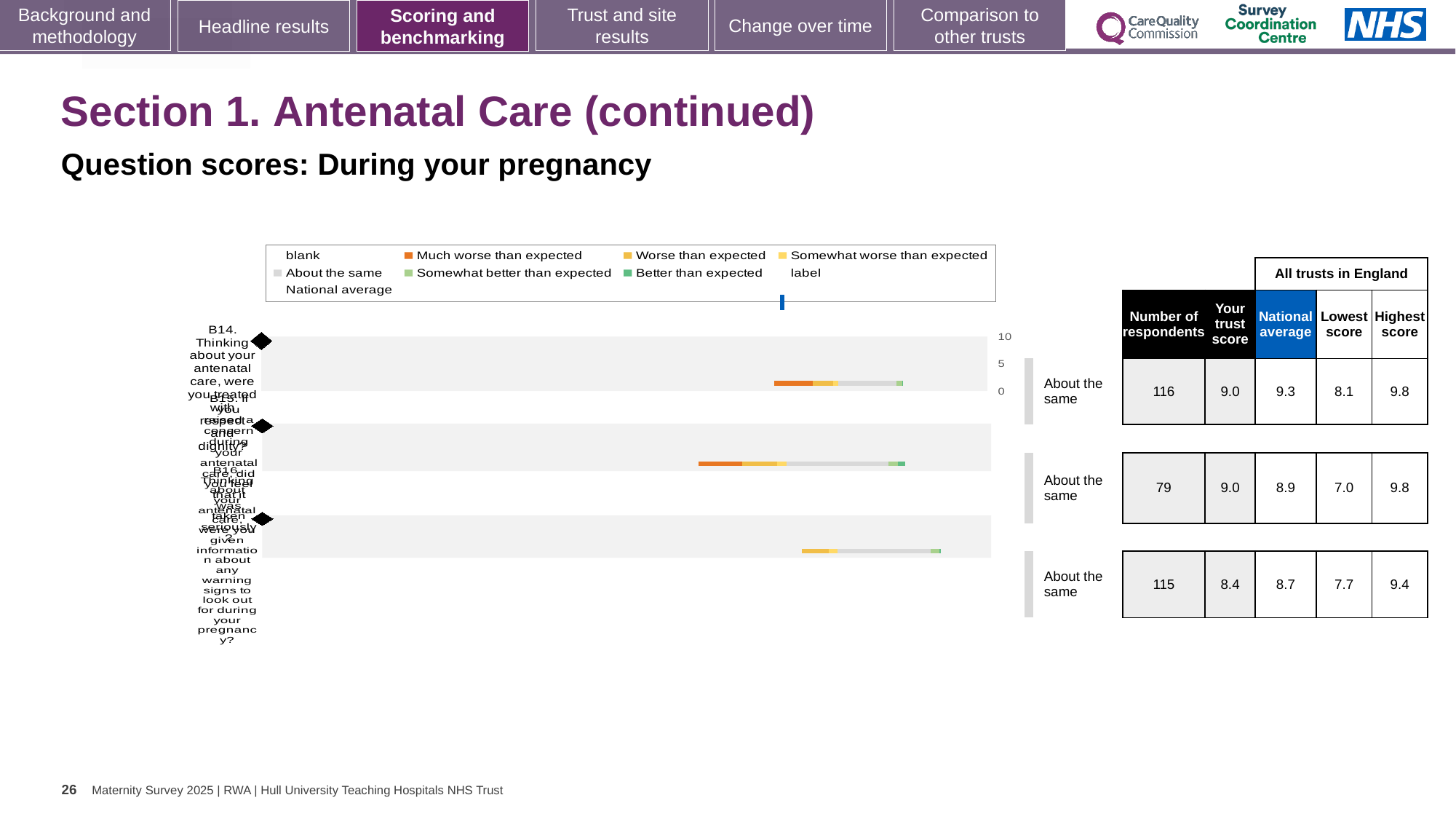
In the table, what is the national average for question B14 (the first row)? 9.3 For the second row, what is the difference between the highest score (9.8) and the lowest score (7.0)? 2.8 Which row has the fewest respondents? the second row (79) In the table, what is the highest score for the third row? 9.4 In the table, what is the lowest score for the second row? 7.0 In the table, what is the 'Your trust score' for question B14 (the first row)? 9.0 How many questions (rows) are plotted in the chart? 3 For the third row, what is the difference between the national average (8.7) and the trust score (8.4)? 0.3 What kind of chart is shown on the slide? bar chart For question B14 (the first row), which is larger: the trust score or the national average? national average What benchmark category is shown next to each of the three rows? About the same In the table, what is the number of respondents for question B14 (the first row)? 116